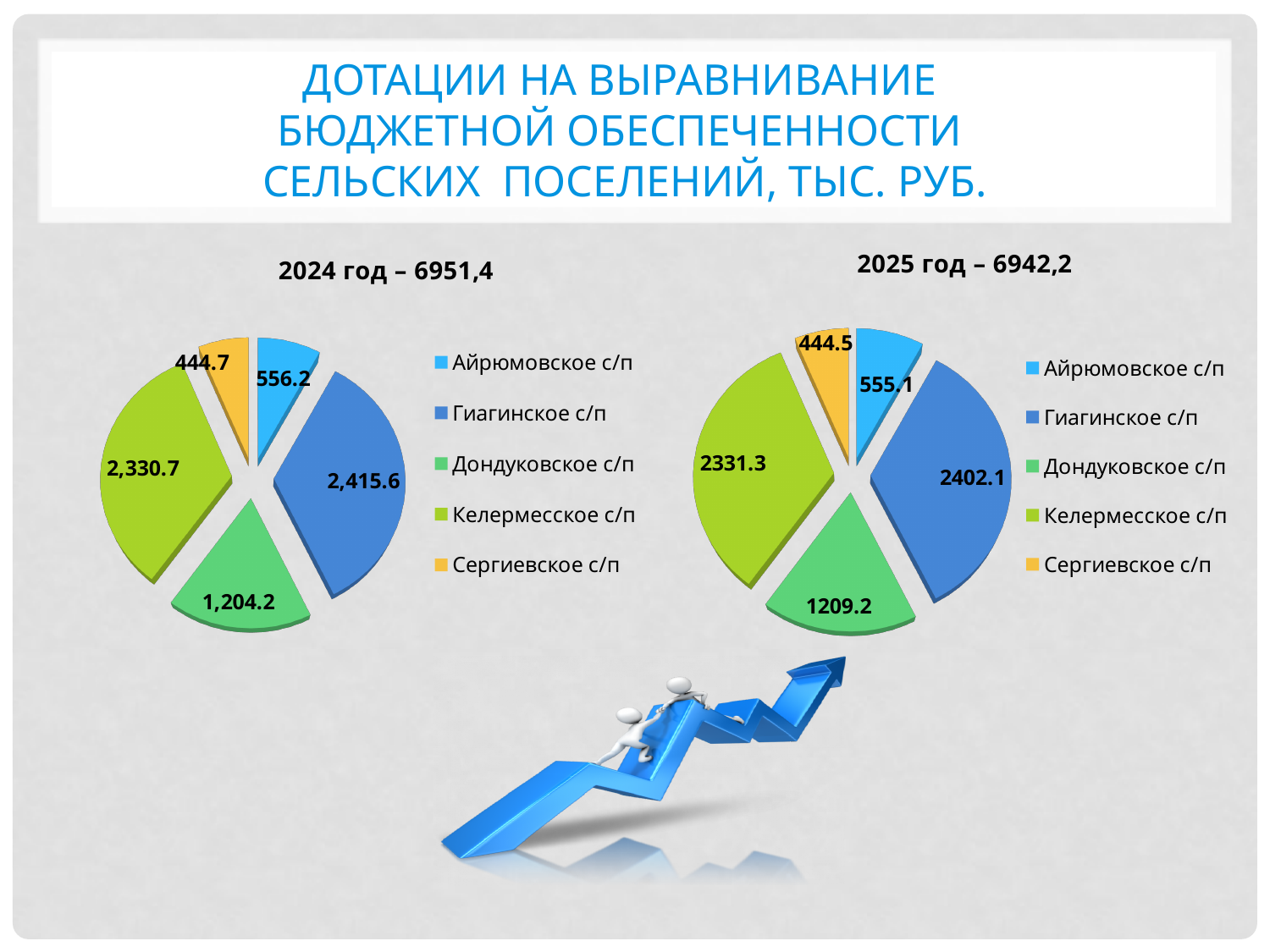
In the 2025 pie chart, what is the difference between Дондуковское с/п and Сергиевское с/п? 764.7 In the 2024 pie chart, which is larger: Гиагинское с/п or Келермесское с/п? Гиагинское с/п What total is shown in the heading of the 2025 chart? 6942,2 In the 2024 pie chart, what is the difference between Гиагинское с/п and Келермесское с/п? 84.9 In the 2025 pie chart, what is the value for Айрюмовское с/п? 555.1 In the 2025 pie chart, what is the value for Дондуковское с/п? 1209.2 In the 2024 pie chart, what is the value for Гиагинское с/п? 2,415.6 How many slices does the 2025 pie chart have? 5 In the 2024 pie chart, which settlement has the smallest value? Сергиевское с/п In the 2024 pie chart, what is the value for Сергиевское с/п? 444.7 In the 2025 pie chart, which settlement has the largest value? Гиагинское с/п What type of chart is used for the 2024 data? Pie chart